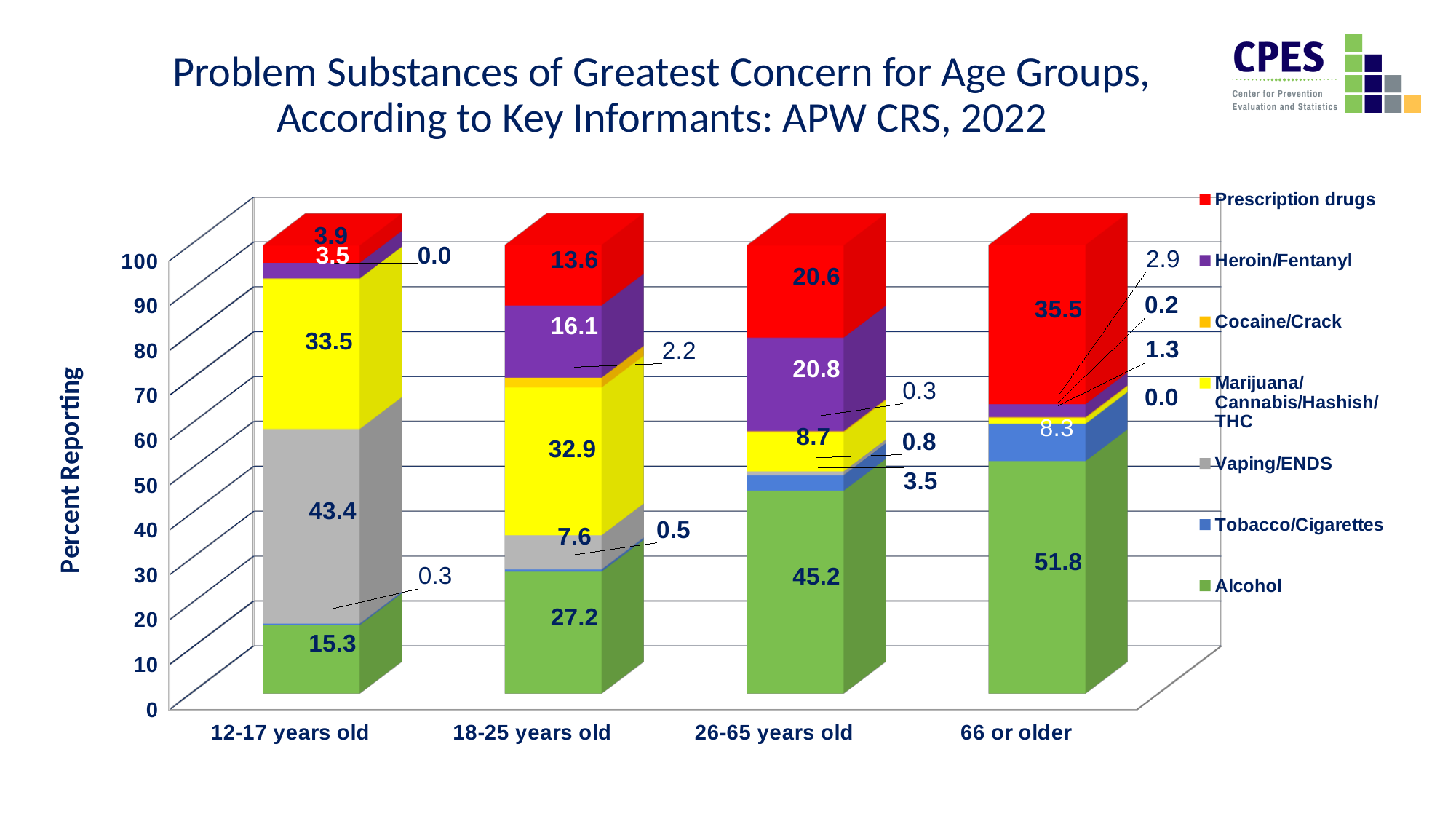
What kind of chart is shown on the slide? Stacked bar chart What is the difference between the Prescription drugs values for the 66 or older group and the 26-65 years old group? 14.9 Which has the larger Heroin/Fentanyl value, the 18-25 years old group or the 26-65 years old group? 26-65 years old What is the value for Vaping/ENDS in the 12-17 years old group? 43.4 Does the Alcohol value rise or fall as the age groups move from youngest to oldest along the x axis? Rise How many series does the legend list? 7 What is the value for Alcohol in the 66 or older group? 51.8 Which age group has the lowest value for Alcohol? 12-17 years old What is the value for Prescription drugs in the 26-65 years old group? 20.6 What is the value for Tobacco/Cigarettes in the 66 or older group? 8.3 Which age group has the highest value for Alcohol? 66 or older How many age groups are shown on the x axis? 4